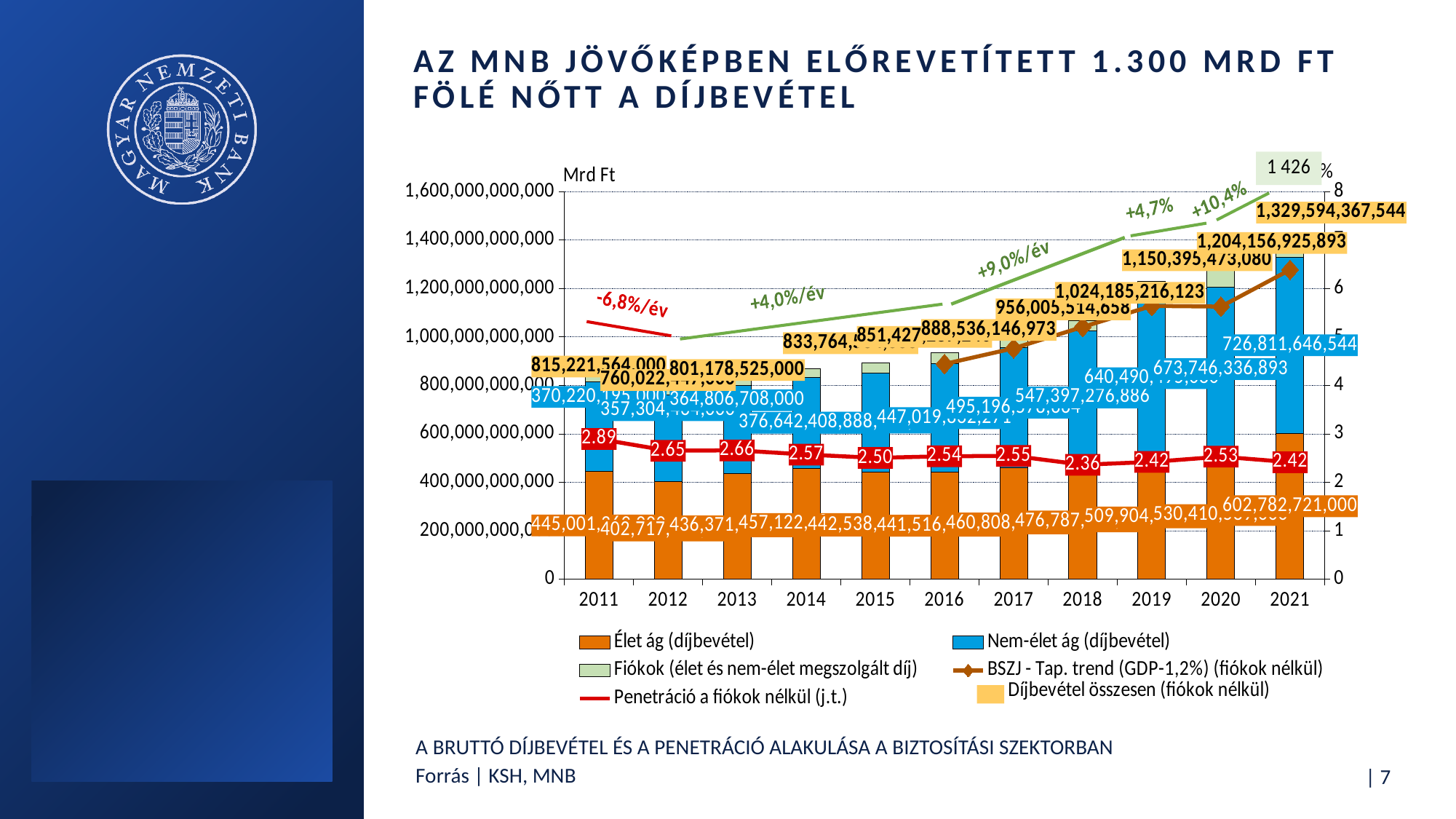
What kind of chart is shown on the slide? A combined bar and line chart (stacked bars with lines) What is the 'Nem-élet ág (díjbevétel)' value for 2021? 726,811,646,544 In which year is the 'Penetráció a fiókok nélkül (j.t.)' value the highest? 2011 What is the 'Díjbevétel összesen (fiókok nélkül)' value for 2018? 1,024,185,216,123 In which year is the 'Penetráció a fiókok nélkül (j.t.)' value the lowest? 2018 What is the value of 'Penetráció a fiókok nélkül (j.t.)' for 2011? 2.89 What is the 'Díjbevétel összesen (fiókok nélkül)' value for 2021? 1,329,594,367,544 Which year has the larger 'Nem-élet ág (díjbevétel)' value, 2017 or 2019? 2019 By how much did the 'Penetráció a fiókok nélkül (j.t.)' value fall from 2011 to 2012? 0.24 How many series does the chart legend list? 6 What is the 'Élet ág (díjbevétel)' value for 2021? 602,782,721,000 How many years are shown on the x axis of the chart? 11